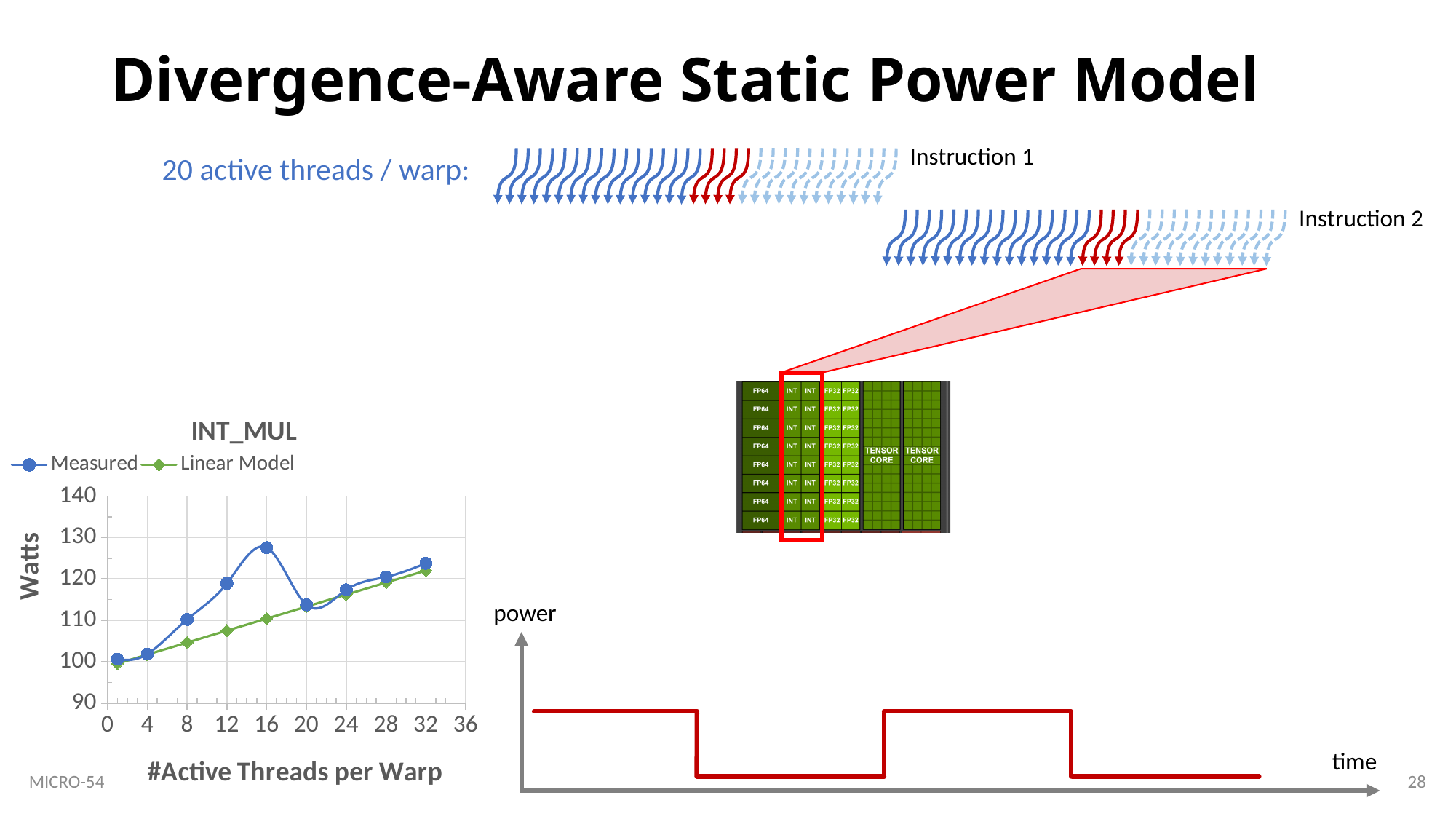
Is the Measured value at 8 active threads per warp greater or less than 100 in the INT_MUL chart? greater What is the y-axis label of the INT_MUL chart? Watts How many series does the legend of the INT_MUL chart list? 2 What kind of chart is the INT_MUL chart? line chart How many data points does the Measured series have in the INT_MUL chart? 9 At which number of active threads per warp does the Measured series reach its highest value in the INT_MUL chart? 16 At 16 active threads per warp, which series has the larger value in the INT_MUL chart, Measured or Linear Model? Measured Is the Linear Model value at 32 active threads per warp greater or less than 120 in the INT_MUL chart? greater Does the Linear Model series rise or fall as the number of active threads per warp increases in the INT_MUL chart? rise What are the two series named in the legend of the INT_MUL chart? Measured and Linear Model Is the Linear Model value at 16 active threads per warp greater or less than 120 in the INT_MUL chart? less